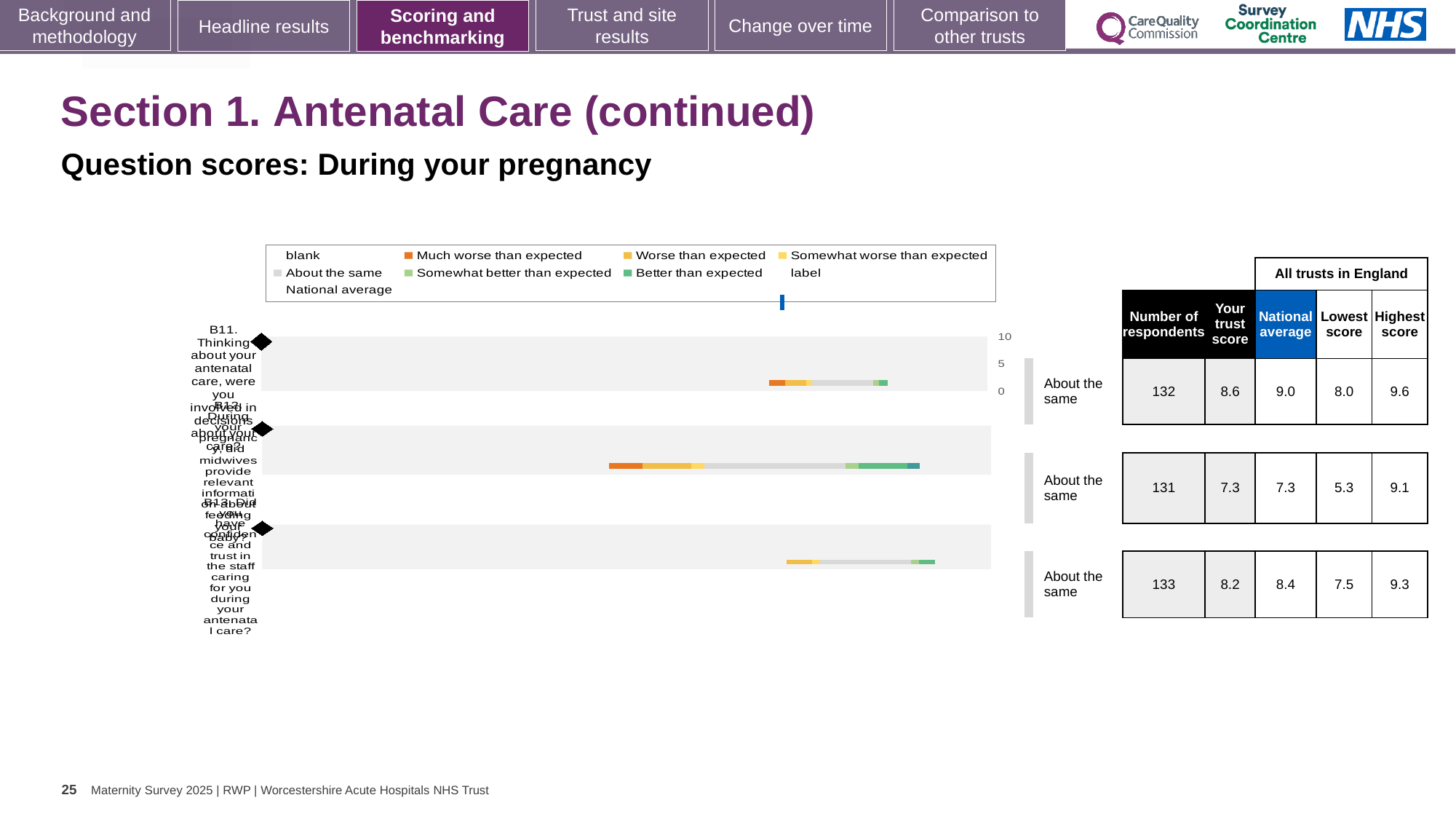
How many questions (B11, B12, B13) are plotted in the chart? 3 What is the difference between the national average and the trust score for question B13? 0.2 What is the difference between the highest score and the lowest score for question B11? 1.6 What is the national average for question B13? 8.4 Which question has the highest trust score? B11 What benchmark category is shown for question B12? About the same For question B11, which is larger: the trust score or the national average? National average What kind of chart is used to show the question scores on this slide? bar chart What is the number of respondents for question B11? 132 What is the trust score for question B12? 7.3 What is the highest tick value shown on the chart's score axis? 10 Which question has the lowest 'Lowest score' across all trusts in England? B12